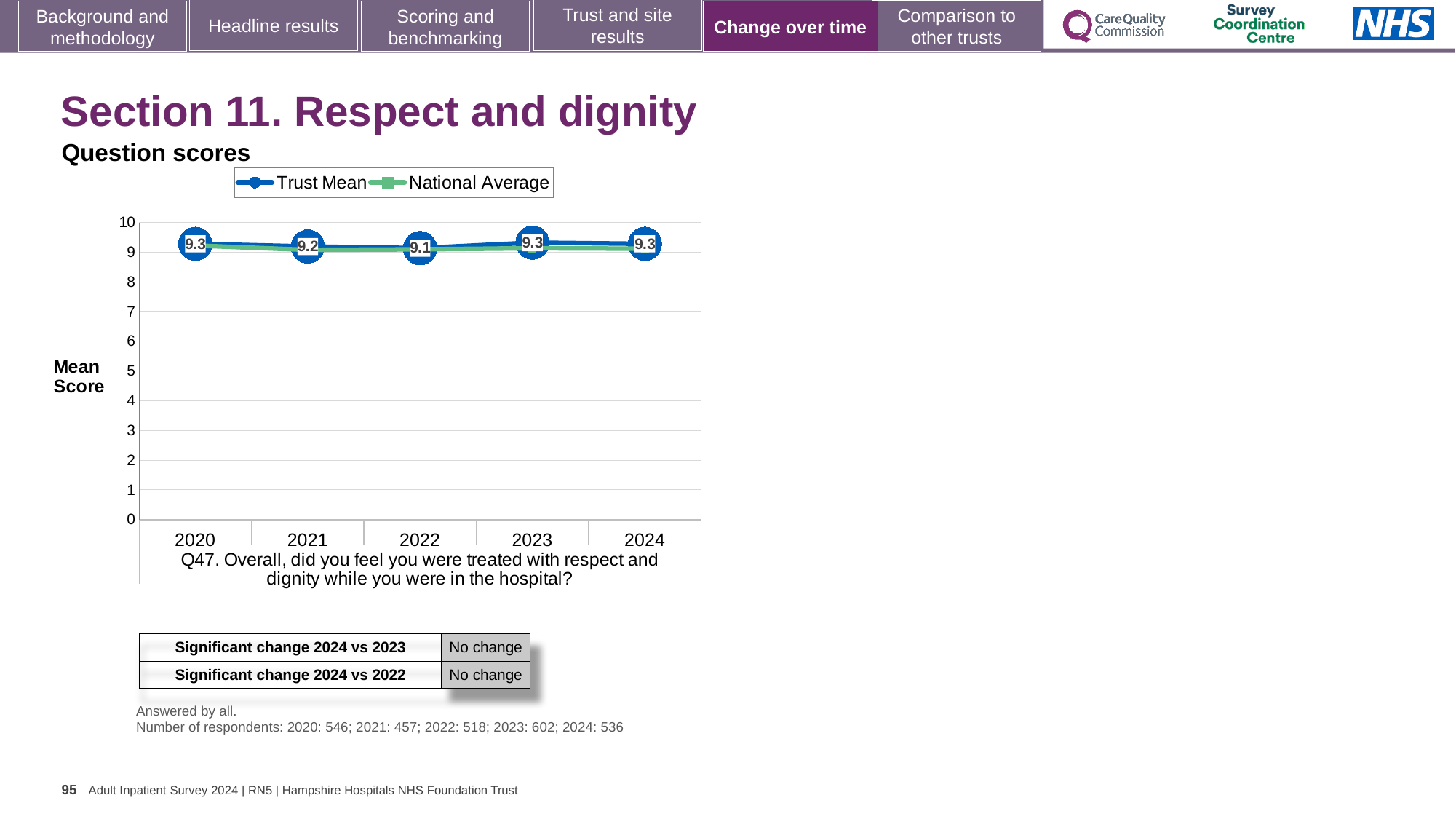
What kind of chart is shown on the slide? Line chart What is the Trust Mean score for 2022? 9.1 Does the Trust Mean score rise or fall from 2022 to 2024? Rise What is the Trust Mean score for 2021? 9.2 In which year is the Trust Mean score lowest? 2022 What is the difference between the Trust Mean score in 2020 and in 2022? 0.2 How many series does the legend list? 2 How many years are plotted on the x axis? 5 Is the National Average value for 2022 greater or less than 8? greater What are the two series named in the legend? Trust Mean and National Average Which year has the higher Trust Mean score, 2021 or 2022? 2021 What is the Trust Mean score for 2020? 9.3